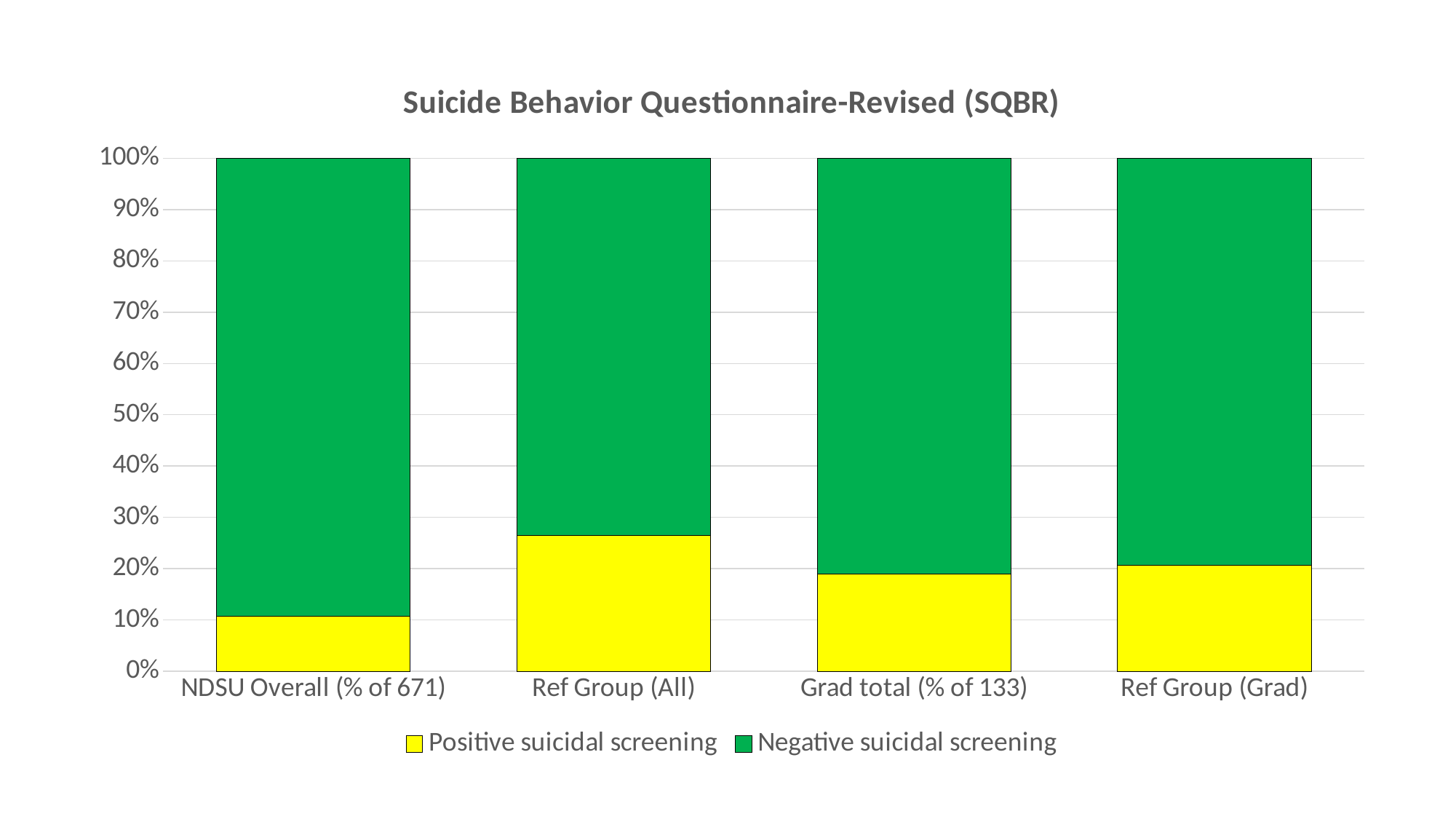
Is the Positive suicidal screening value for NDSU Overall (% of 671) greater or less than 20%? less How many series does the legend list? 2 Which colour represents Positive suicidal screening in the chart? yellow How many categories are shown on the x axis? 4 What kind of chart is shown on the slide? bar chart Which category has the highest Positive suicidal screening share? Ref Group (All) What is the total height of the stacked bar for NDSU Overall (% of 671)? 100% Which has a larger Positive suicidal screening share, NDSU Overall (% of 671) or Ref Group (All)? Ref Group (All) Which category has the lowest Positive suicidal screening share? NDSU Overall (% of 671) Is the Positive suicidal screening value for Ref Group (All) greater or less than 20%? greater What is the title of the chart? Suicide Behavior Questionnaire-Revised (SQBR) Is the Positive suicidal screening value for Grad total (% of 133) greater or less than 30%? less